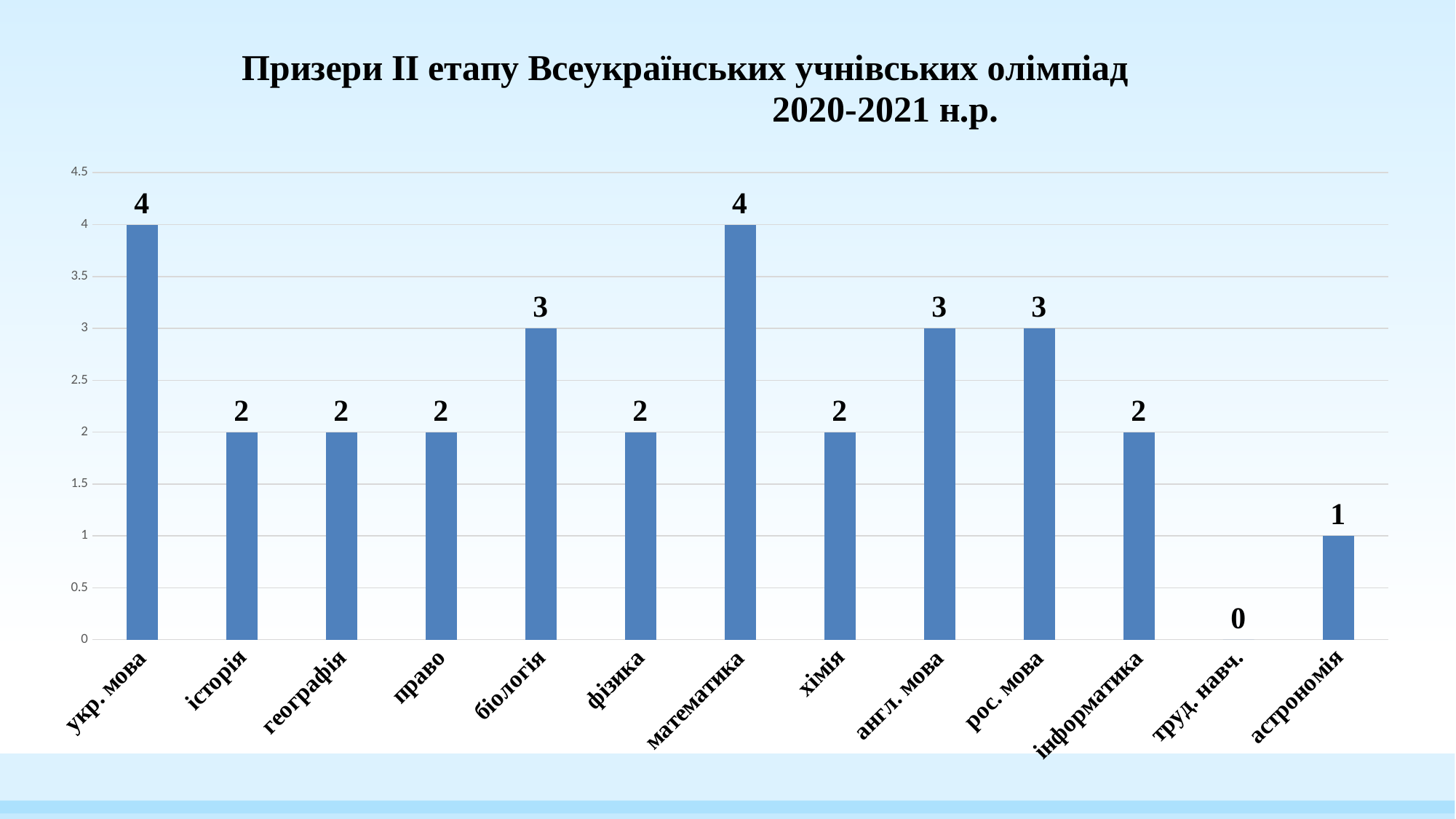
What is the value for астрономія? 1 How many categories are shown on the x axis? 13 What is the value for біологія? 3 Which is larger, the value for історія or the value for укр. мова? укр. мова What is the value for укр. мова? 4 What kind of chart is shown on the slide? bar chart What is the difference between the values for англ. мова and астрономія? 2 What is the title of the chart? Призери ІІ етапу Всеукраїнських учнівських олімпіад 2020-2021 н.р. What is the difference between the values for математика and хімія? 2 Which is larger, the value for рос. мова or the value for інформатика? рос. мова Which category has the lowest value? труд. навч. What is the value for труд. навч.? 0